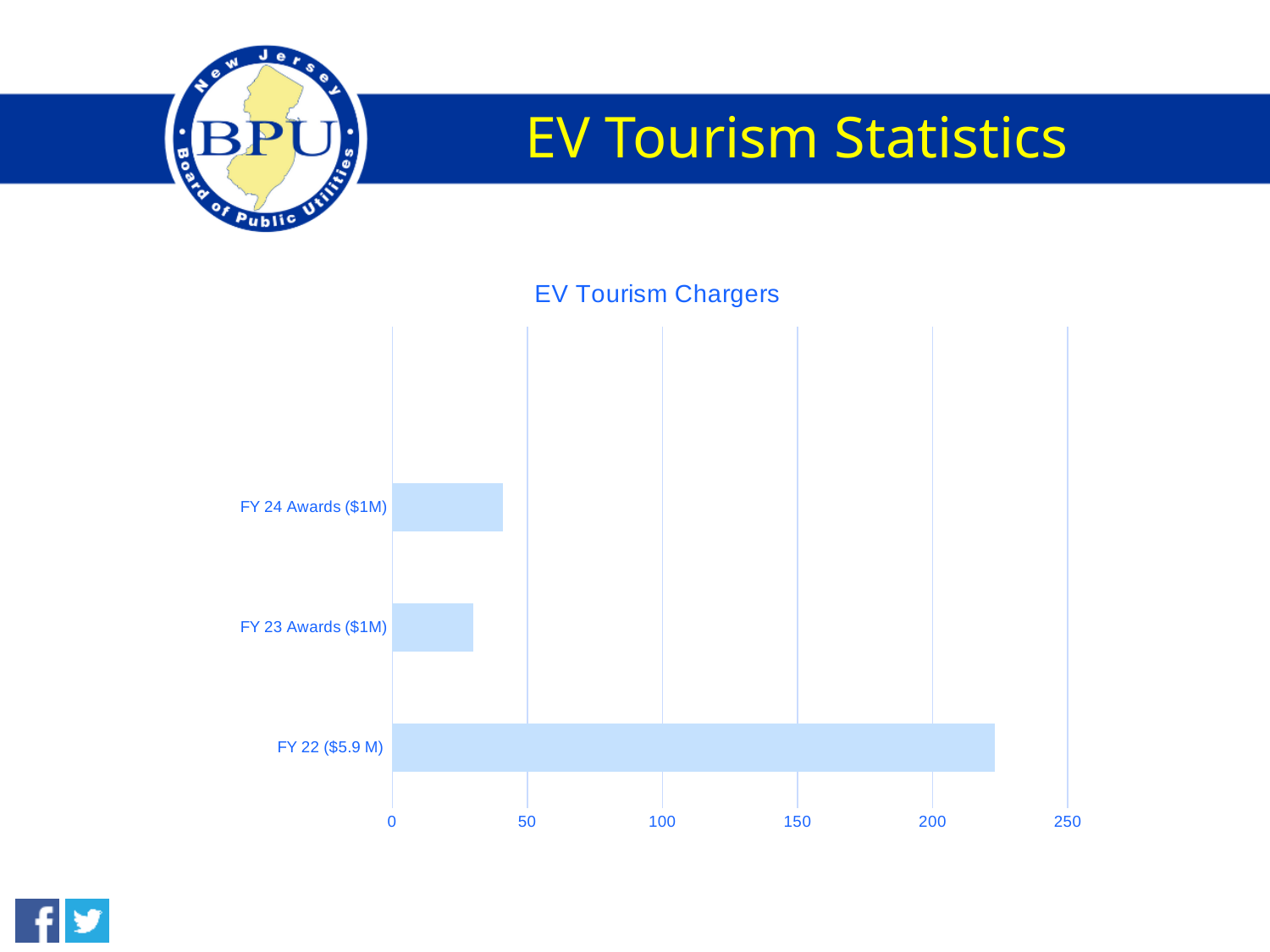
Is the value for FY 24 Awards ($1M) greater or less than 50? less Is the value for FY 22 ($5.9 M) greater or less than 250? less Which category has the lowest value in the EV Tourism Chargers chart? FY 23 Awards ($1M) What is the title of the chart? EV Tourism Chargers Which category has the highest value in the EV Tourism Chargers chart? FY 22 ($5.9 M) How many categories are plotted in the EV Tourism Chargers chart? 3 Is the value for FY 23 Awards ($1M) greater or less than 50? less What kind of chart is shown on the slide? bar chart Which is larger, the value for FY 24 Awards ($1M) or FY 23 Awards ($1M)? FY 24 Awards ($1M) Which is larger, the value for FY 22 ($5.9 M) or FY 24 Awards ($1M)? FY 22 ($5.9 M) What is the maximum value shown on the horizontal axis of the chart? 250